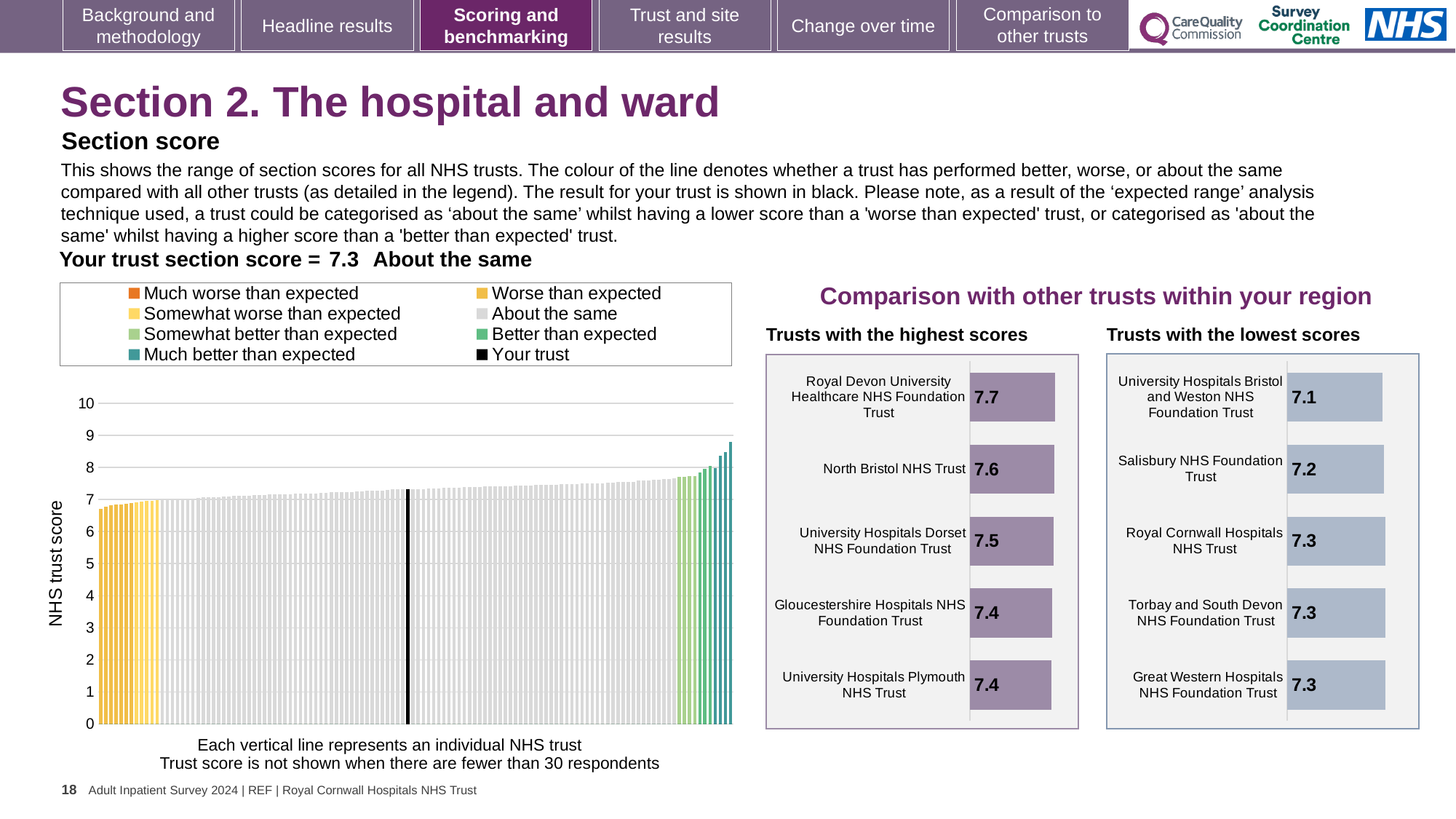
In the 'Trusts with the highest scores' chart, which trust has the highest score? Royal Devon University Healthcare NHS Foundation Trust In the 'Trusts with the lowest scores' chart, what is the score for Salisbury NHS Foundation Trust? 7.2 In the 'Trusts with the highest scores' chart, what is the score for Royal Devon University Healthcare NHS Foundation Trust? 7.7 In the large chart on the left showing all NHS trusts, is the value for your trust (the black line) greater or less than 5? greater What kind of chart is the 'Trusts with the highest scores' chart? bar chart In the 'Trusts with the lowest scores' chart, which trust has the lowest score? University Hospitals Bristol and Weston NHS Foundation Trust In the 'Trusts with the lowest scores' chart, which has the larger score: University Hospitals Bristol and Weston NHS Foundation Trust or Royal Cornwall Hospitals NHS Trust? Royal Cornwall Hospitals NHS Trust How many trusts are shown in the 'Trusts with the lowest scores' chart? 5 How many entries does the legend of the large chart on the left list? 8 In the 'Trusts with the highest scores' chart, what is the score for University Hospitals Dorset NHS Foundation Trust? 7.5 In the 'Trusts with the highest scores' chart, what is the difference between the scores of Royal Devon University Healthcare NHS Foundation Trust and University Hospitals Plymouth NHS Trust? 0.3 In the 'Trusts with the lowest scores' chart, what is the score for Great Western Hospitals NHS Foundation Trust? 7.3